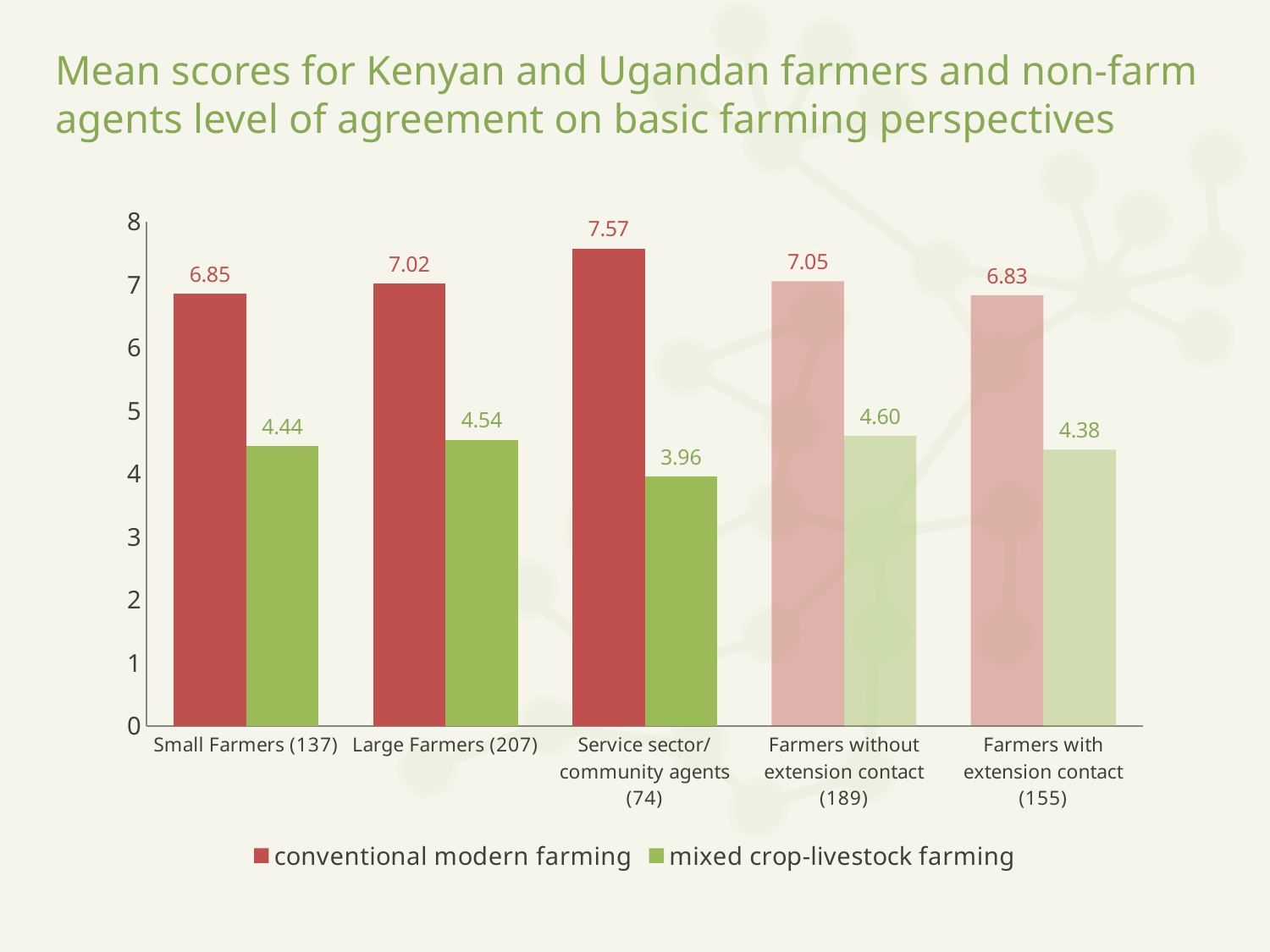
What colour are the mixed crop-livestock farming bars? Green Which category has the highest conventional modern farming score? Service sector/community agents (74) How many series does the legend list? 2 How many categories are shown on the x axis? 5 What is the mixed crop-livestock farming score for Farmers with extension contact (155)? 4.38 What is the conventional modern farming score for Small Farmers (137)? 6.85 What is the difference between the conventional modern farming and mixed crop-livestock farming scores for Large Farmers (207)? 2.48 Which is larger: the mixed crop-livestock farming score for Farmers without extension contact (189) or for Farmers with extension contact (155)? Farmers without extension contact (189) Which category has the lowest mixed crop-livestock farming score? Service sector/community agents (74) What kind of chart is shown on the slide? Bar chart What is the conventional modern farming score for Farmers without extension contact (189)? 7.05 What is the mixed crop-livestock farming score for Service sector/community agents (74)? 3.96